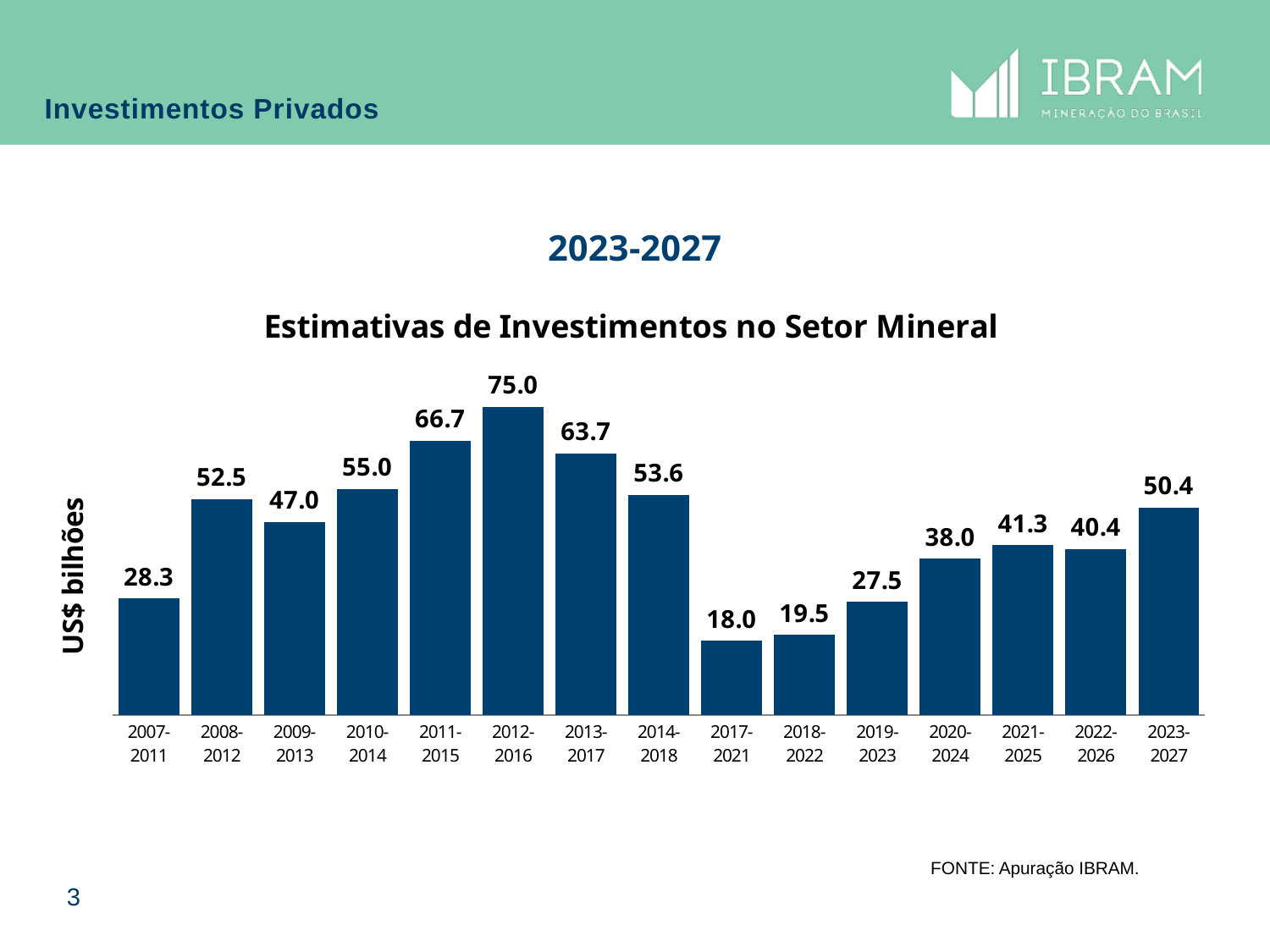
What kind of chart is shown on the slide? Bar chart What is the value shown for the 2017-2021 period? 18.0 Do the values rise or fall from 2017-2021 to 2023-2027? Rise Which period has the highest estimated investment? 2012-2016 What is the estimated investment value for the 2023-2027 period? 50.4 What unit is shown on the y axis label of the chart? US$ bilhões How many periods are shown on the x axis of the chart? 15 What is the estimated investment value for the 2012-2016 period? 75.0 Which period has the lowest estimated investment? 2017-2021 What is the difference between the values for 2023-2027 and 2022-2026? 10.0 Which is larger, the value for 2008-2012 or the value for 2009-2013? 2008-2012 What is the difference between the values for 2012-2016 and 2017-2021? 57.0